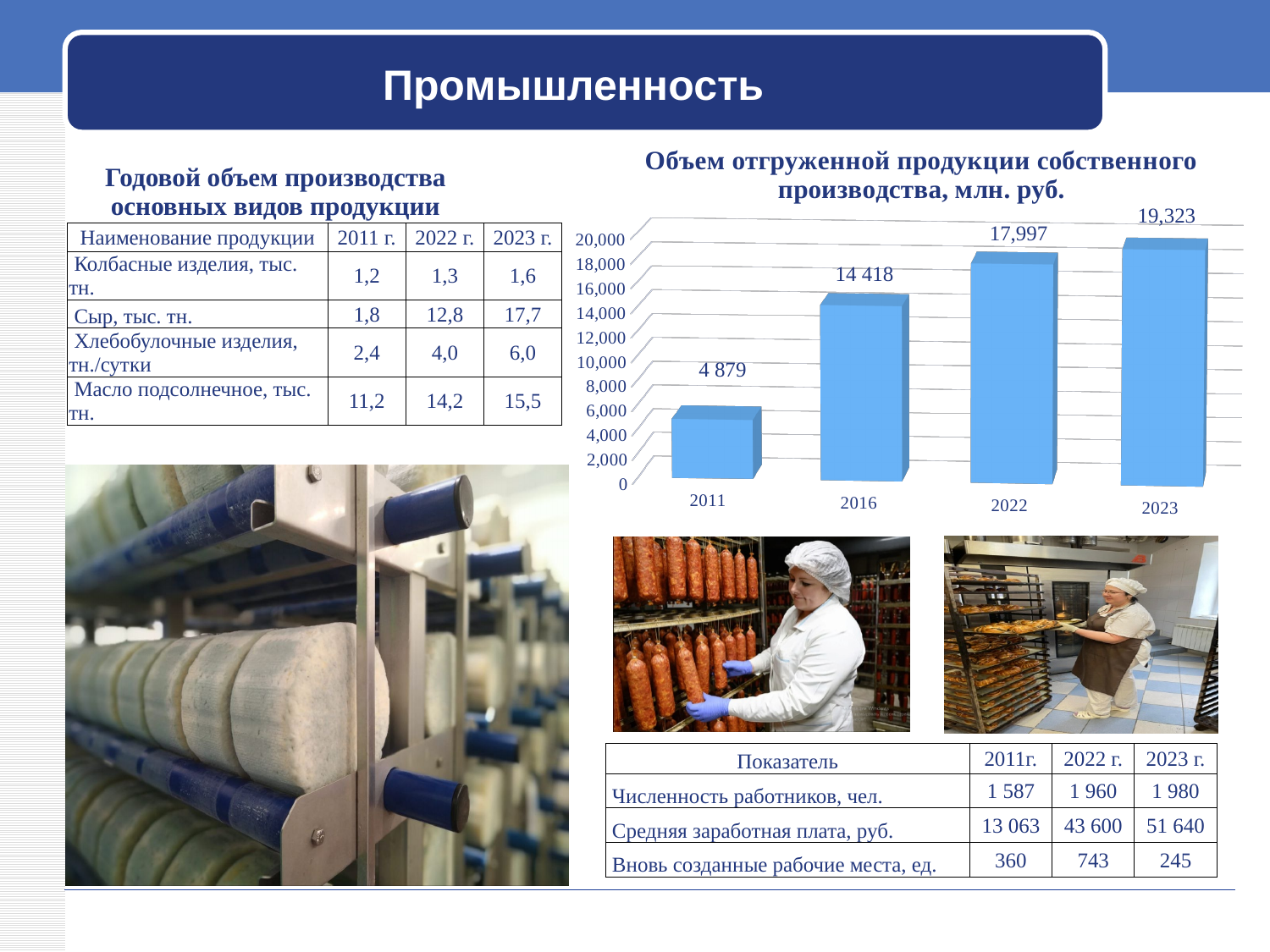
How many years (bars) are shown in the chart 'Объем отгруженной продукции собственного производства, млн. руб.'? 4 What is the value for 2023 in the chart 'Объем отгруженной продукции собственного производства, млн. руб.'? 19,323 What is the value for 2016 in the chart 'Объем отгруженной продукции собственного производства, млн. руб.'? 14 418 What kind of chart is 'Объем отгруженной продукции собственного производства, млн. руб.'? Bar chart Which year has the lowest value in the chart 'Объем отгруженной продукции собственного производства, млн. руб.'? 2011 In the chart 'Объем отгруженной продукции собственного производства, млн. руб.', do the values rise or fall from 2011 to 2023? Rise What is the value for 2011 in the chart 'Объем отгруженной продукции собственного производства, млн. руб.'? 4 879 In the chart 'Объем отгруженной продукции собственного производства, млн. руб.', what is the difference between the values for 2016 and 2011? 9 539 Which year has the highest value in the chart 'Объем отгруженной продукции собственного производства, млн. руб.'? 2023 In the chart 'Объем отгруженной продукции собственного производства, млн. руб.', what is the difference between the values for 2023 and 2022? 1,326 In the chart 'Объем отгруженной продукции собственного производства, млн. руб.', which is larger, the value for 2016 or the value for 2022? 2022 What is the value for 2022 in the chart 'Объем отгруженной продукции собственного производства, млн. руб.'? 17,997